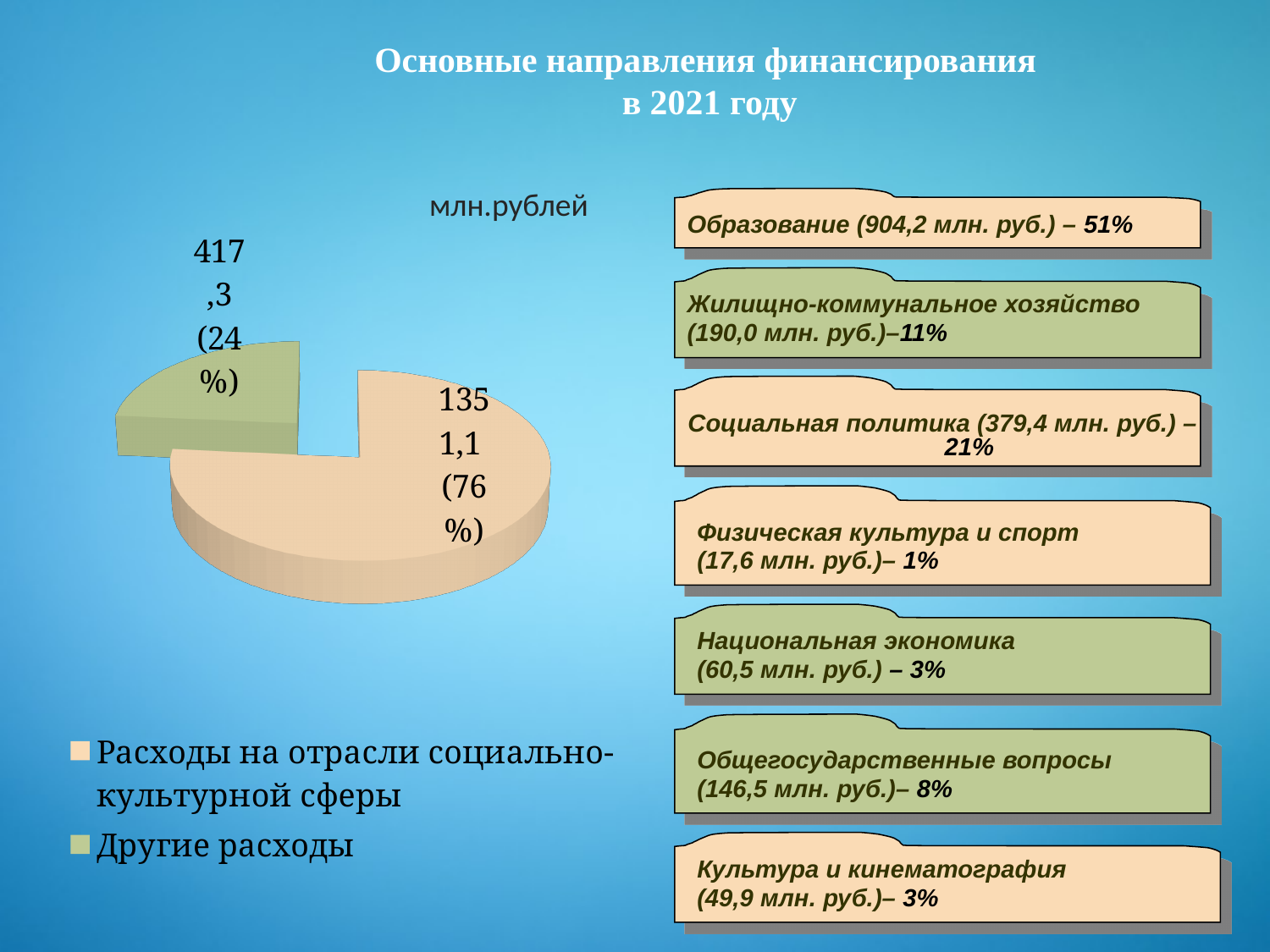
How many slices does the pie chart have? 2 What value is shown for "Другие расходы" in the pie chart? 417,3 Which is larger in the pie chart: "Расходы на отрасли социально-культурной сферы" or "Другие расходы"? Расходы на отрасли социально-культурной сферы What value is shown for "Расходы на отрасли социально-культурной сферы" in the pie chart? 1351,1 What share of the pie does "Расходы на отрасли социально-культурной сферы" represent? 76% What share of the pie does "Другие расходы" represent? 24% Which slice of the pie chart is the largest? Расходы на отрасли социально-культурной сферы What unit label is shown above the pie chart? млн.рублей Which slice of the pie chart is the smallest? Другие расходы What kind of chart is shown on the slide? pie chart How many entries does the legend of the pie chart list? 2 What is the difference between the values for "Расходы на отрасли социально-культурной сферы" and "Другие расходы" in the pie chart? 933,8